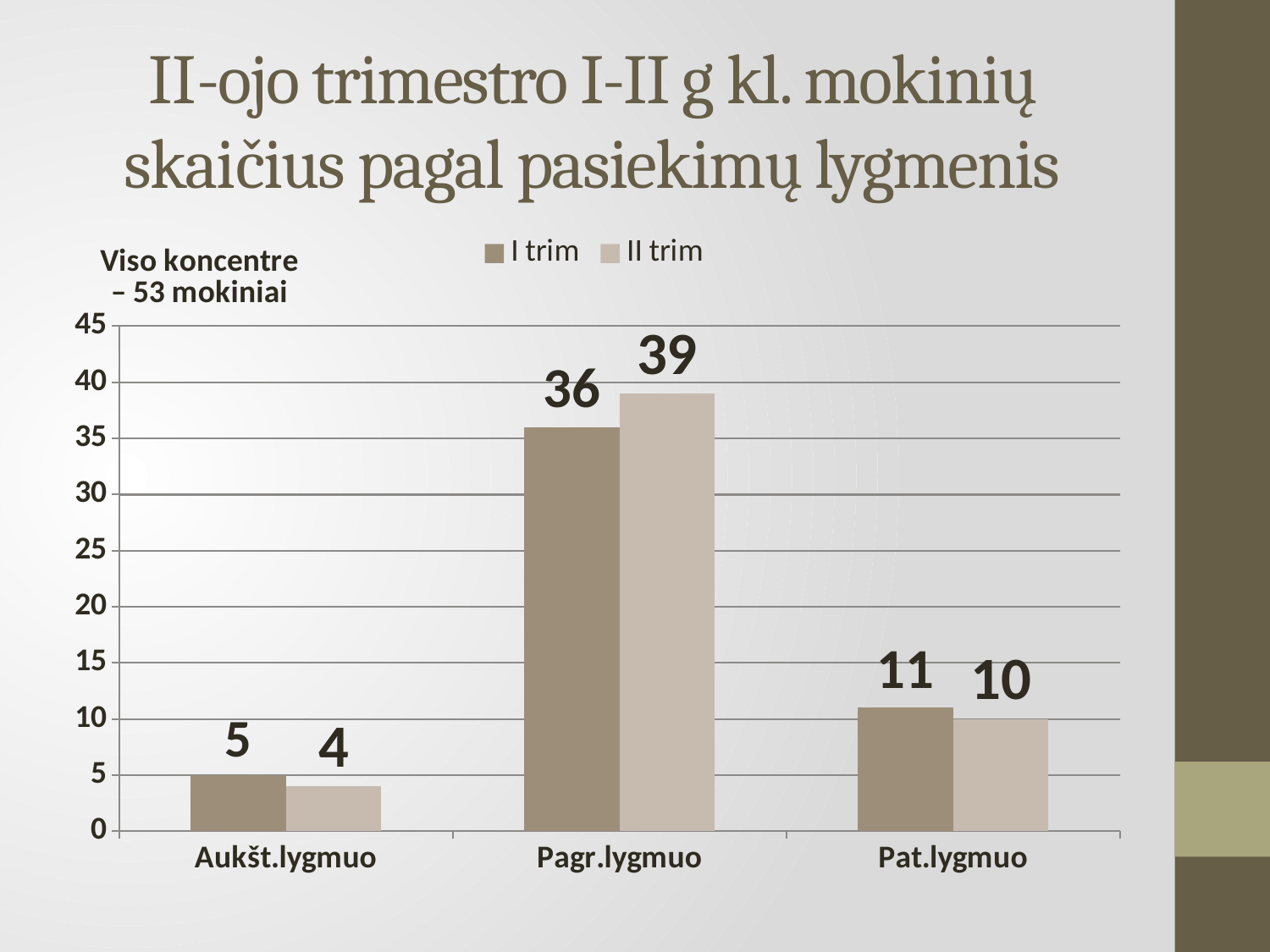
Which is larger for Pat.lygmuo, the I trim value or the II trim value? I trim What total number of students is stated in the text above the chart? 53 mokiniai Which category has the highest value for II trim? Pagr.lygmuo What is the value for I trim in the Pagr.lygmuo category? 36 What is the value for II trim in the Pat.lygmuo category? 10 What is the value for II trim in the Aukšt.lygmuo category? 4 How many categories are shown on the x axis? 3 Is the value for I trim in Pagr.lygmuo greater or less than 30? greater How many series does the legend list? 2 Which category has the lowest value for I trim? Aukšt.lygmuo What is the difference between the II trim and I trim values for Pagr.lygmuo? 3 What kind of chart is shown on the slide? bar chart